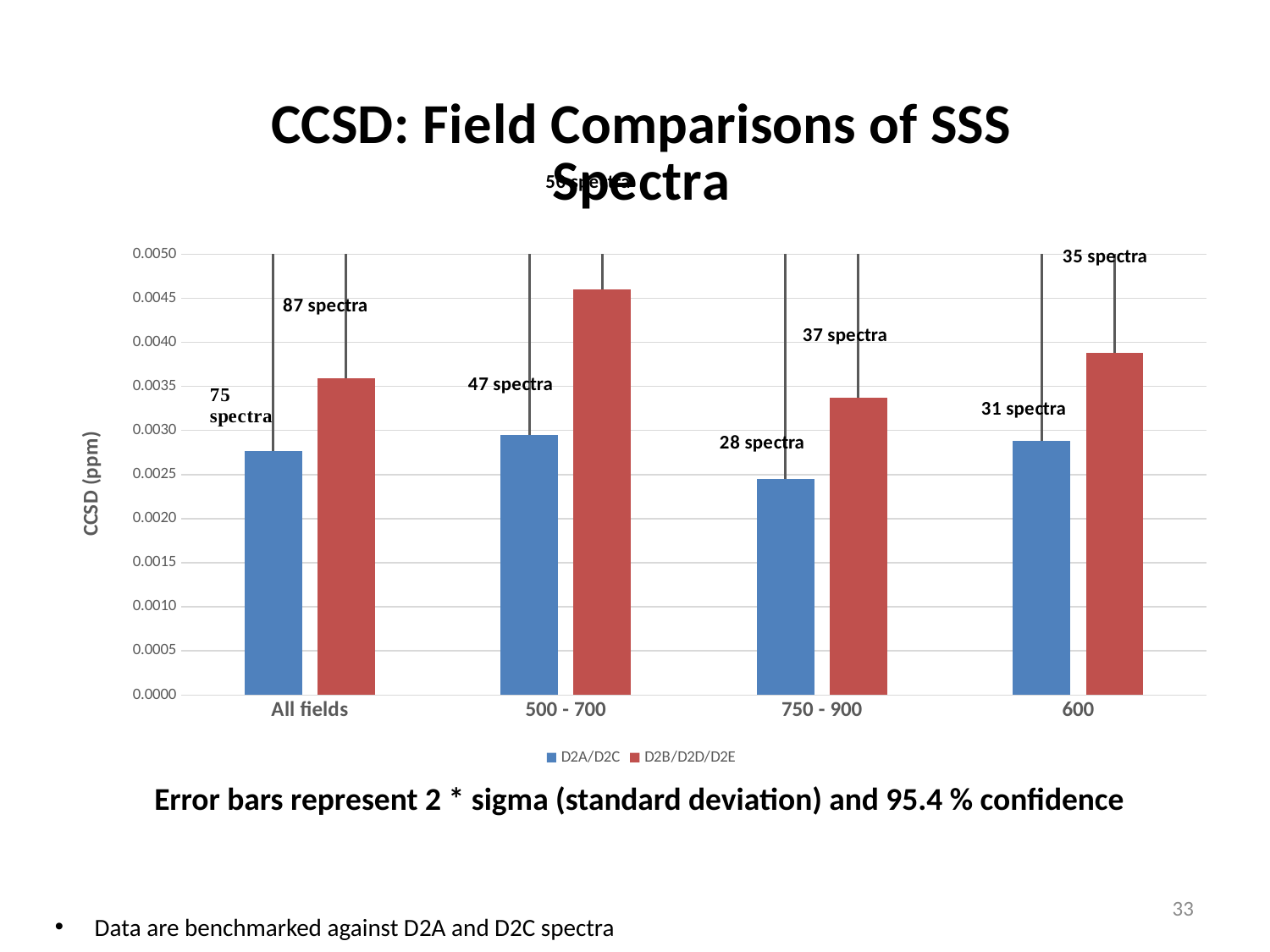
For the 500 - 700 category, which series has the larger value, D2A/D2C or D2B/D2D/D2E? D2B/D2D/D2E Is the D2A/D2C value for 750 - 900 greater or less than 0.0020? greater Is the D2A/D2C value for All fields greater or less than 0.0030? less How many series does the legend list? 2 What kind of chart is shown on the slide? bar chart Which category has the highest D2B/D2D/D2E value? 500 - 700 Is the D2B/D2D/D2E value for 600 greater or less than 0.0035? greater How many categories are shown on the x axis? 4 Which category has the lowest D2A/D2C value? 750 - 900 Which category has the lowest D2B/D2D/D2E value? 750 - 900 What is the label on the y axis of the chart? CCSD (ppm)